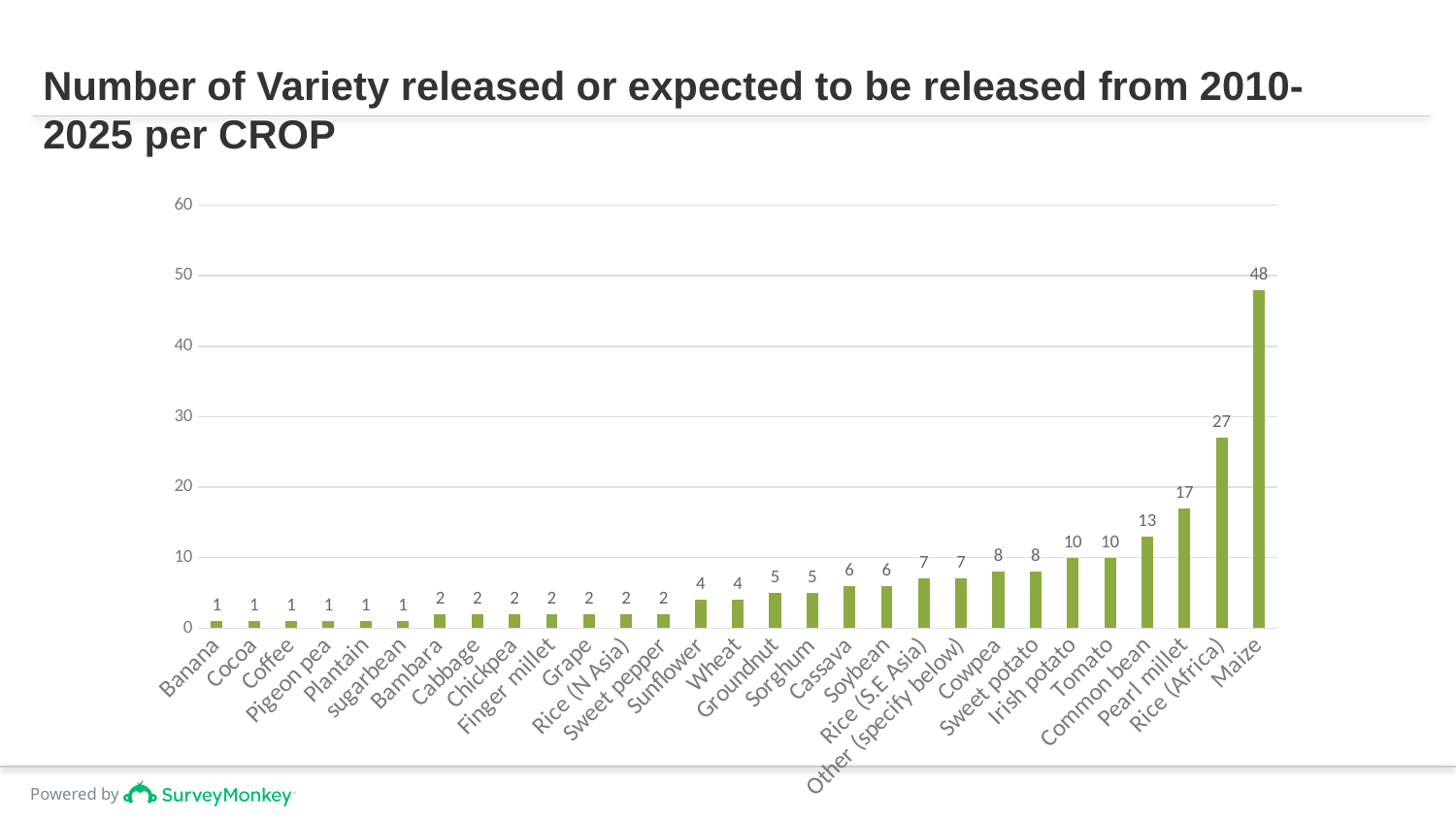
What kind of chart is shown on the slide? bar chart Do the values rise or fall from left to right along the x axis? rise What is the value for Maize? 48 What is the value for Common bean? 13 Which is larger, the value for Tomato or the value for Sorghum? Tomato Is the value for Maize greater or less than 40? greater What is the value for Cowpea? 8 Which crop has the highest number of varieties? Maize What is the difference between the values for Maize and Rice (Africa)? 21 What is the value for Pearl millet? 17 How many crops are shown on the x axis? 29 What is the value for Rice (Africa)? 27